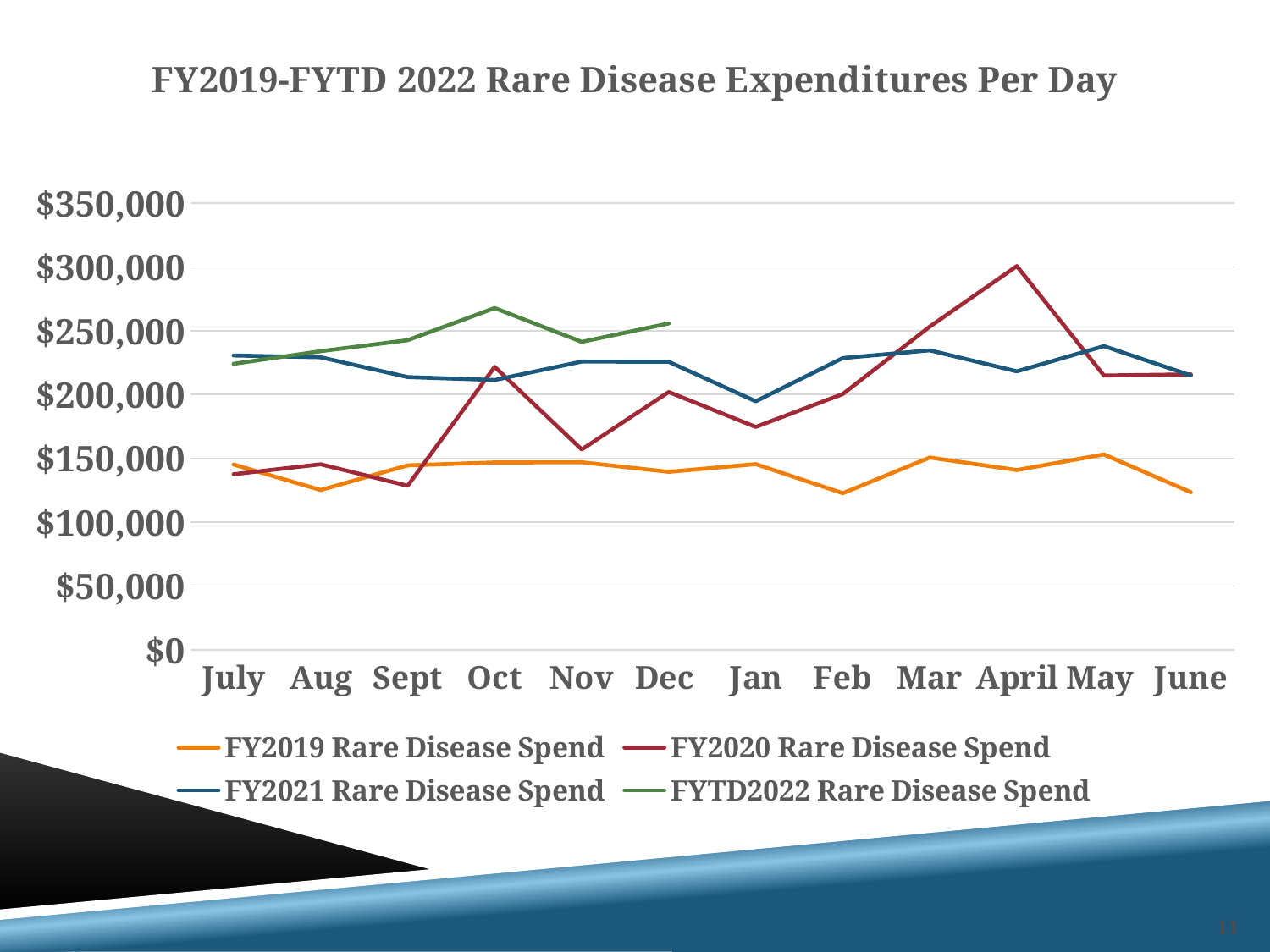
How many months are shown along the x axis? 12 In which month does the FY2021 Rare Disease Spend series reach its lowest value? Jan In Oct, which series has the higher value: FY2020 Rare Disease Spend or FY2019 Rare Disease Spend? FY2020 Rare Disease Spend In which month does the FY2020 Rare Disease Spend series reach its highest value? April How many series does the legend list? 4 Is the FY2020 Rare Disease Spend value for Nov greater or less than $200,000? less How many months have a plotted value for the FYTD2022 Rare Disease Spend series? 6 Does the FY2020 Rare Disease Spend series rise or fall from Jan to April? Rise In which month does the FYTD2022 Rare Disease Spend series reach its highest value? Oct Is the FY2020 Rare Disease Spend value for April greater or less than $250,000? greater What type of chart is shown on the slide? Line chart Is the FY2019 Rare Disease Spend value for Aug greater or less than $150,000? less